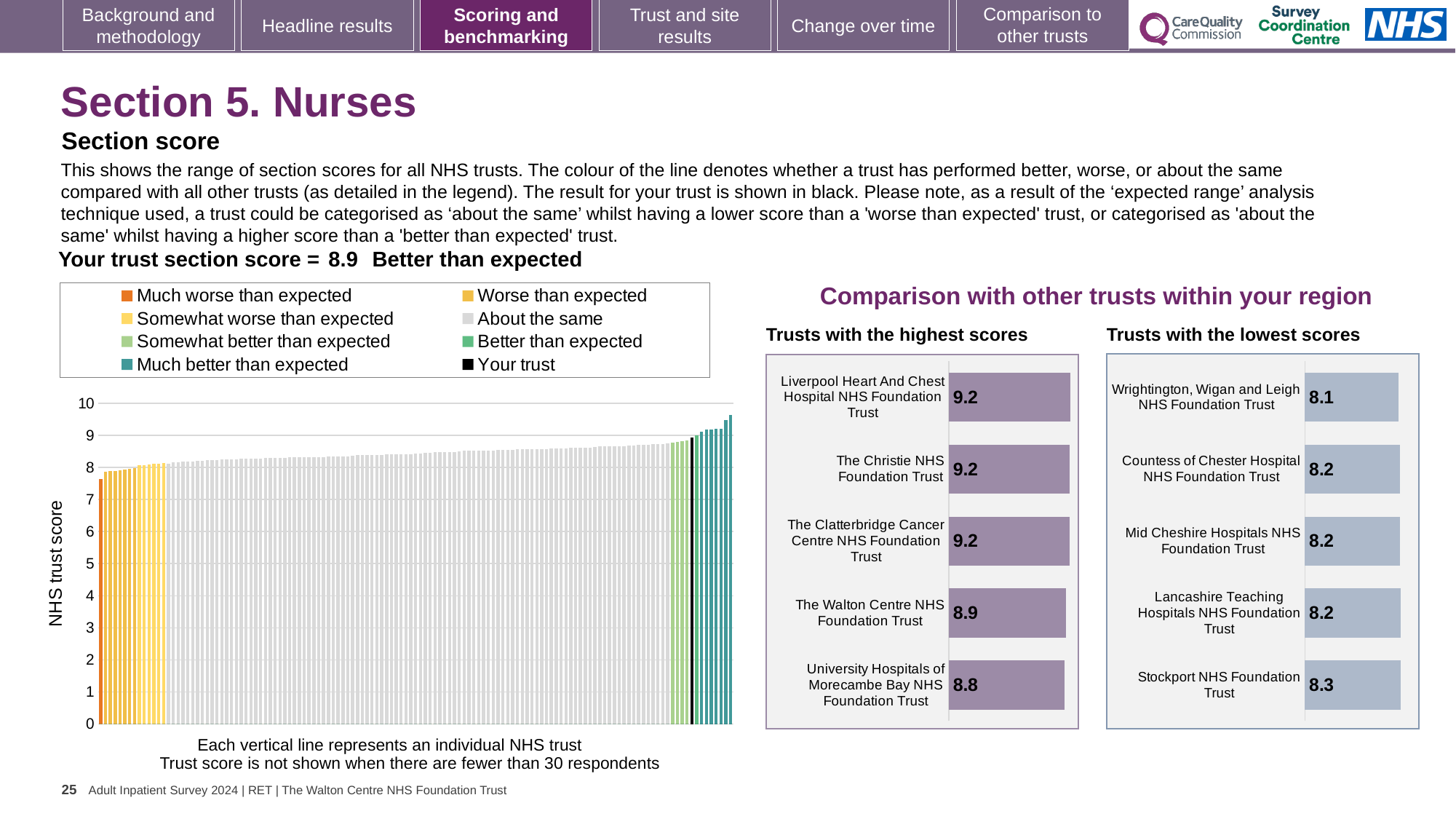
In the 'Trusts with the highest scores' chart, what is the score for The Walton Centre NHS Foundation Trust? 8.9 In the 'Trusts with the highest scores' chart, what is the difference between the score for Liverpool Heart And Chest Hospital NHS Foundation Trust and the score for University Hospitals of Morecambe Bay NHS Foundation Trust? 0.4 In the 'Trusts with the lowest scores' chart, which trust has the highest score? Stockport NHS Foundation Trust Which is larger: the score for The Walton Centre NHS Foundation Trust in the 'Trusts with the highest scores' chart or the score for Stockport NHS Foundation Trust in the 'Trusts with the lowest scores' chart? The Walton Centre NHS Foundation Trust In the 'Trusts with the lowest scores' chart, what is the score for Wrightington, Wigan and Leigh NHS Foundation Trust? 8.1 In the 'Trusts with the highest scores' chart, which trust has the lowest score? University Hospitals of Morecambe Bay NHS Foundation Trust In the 'Trusts with the lowest scores' chart, what is the difference between the score for Stockport NHS Foundation Trust and the score for Wrightington, Wigan and Leigh NHS Foundation Trust? 0.2 How many trusts are shown in the 'Trusts with the lowest scores' chart? 5 In the large 'NHS trust score' chart, do the bar values rise or fall from left to right along the x axis? Rise In the 'Trusts with the highest scores' chart, what is the score for University Hospitals of Morecambe Bay NHS Foundation Trust? 8.8 How many entries does the legend of the large 'NHS trust score' chart list? 8 What kind of chart is the large chart with the 'NHS trust score' axis? Bar chart